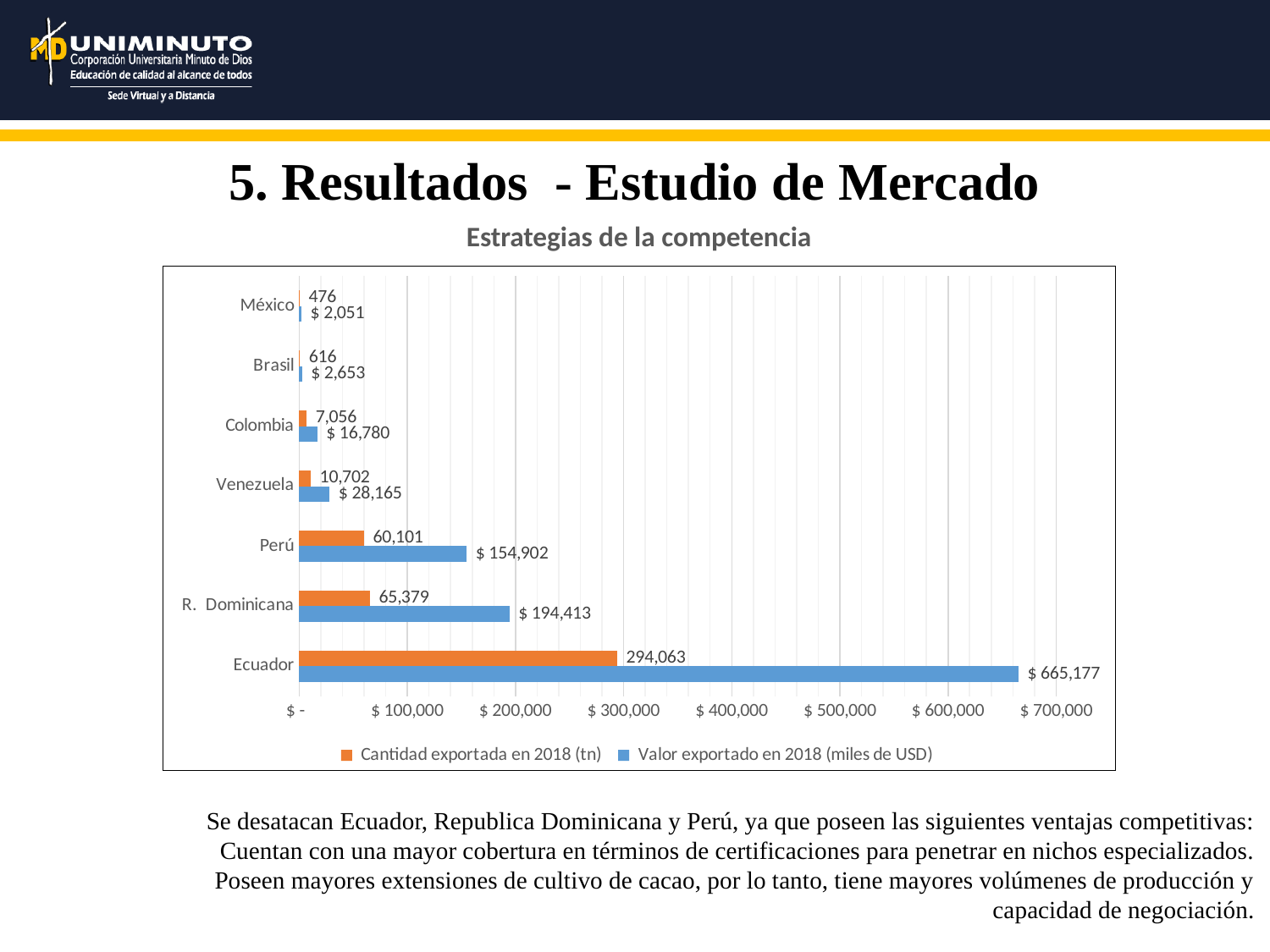
How many series does the legend list? 2 Which country has the highest value exported in 2018 (miles de USD)? Ecuador What is the difference between the value exported in 2018 (miles de USD) for R. Dominicana and Perú? $ 39,511 How many countries are shown in the chart? 7 Which has a larger quantity exported in 2018 (tn), Colombia or Venezuela? Venezuela What is the quantity exported in 2018 (tn) for Brasil? 616 What is the title of the chart? Estrategias de la competencia What kind of chart is shown on the slide? Bar chart What is the value exported in 2018 (miles de USD) for Venezuela? $ 28,165 Which country has the lowest quantity exported in 2018 (tn)? México What is the quantity exported in 2018 (tn) for Perú? 60,101 What is the value exported in 2018 (miles de USD) for Ecuador? $ 665,177